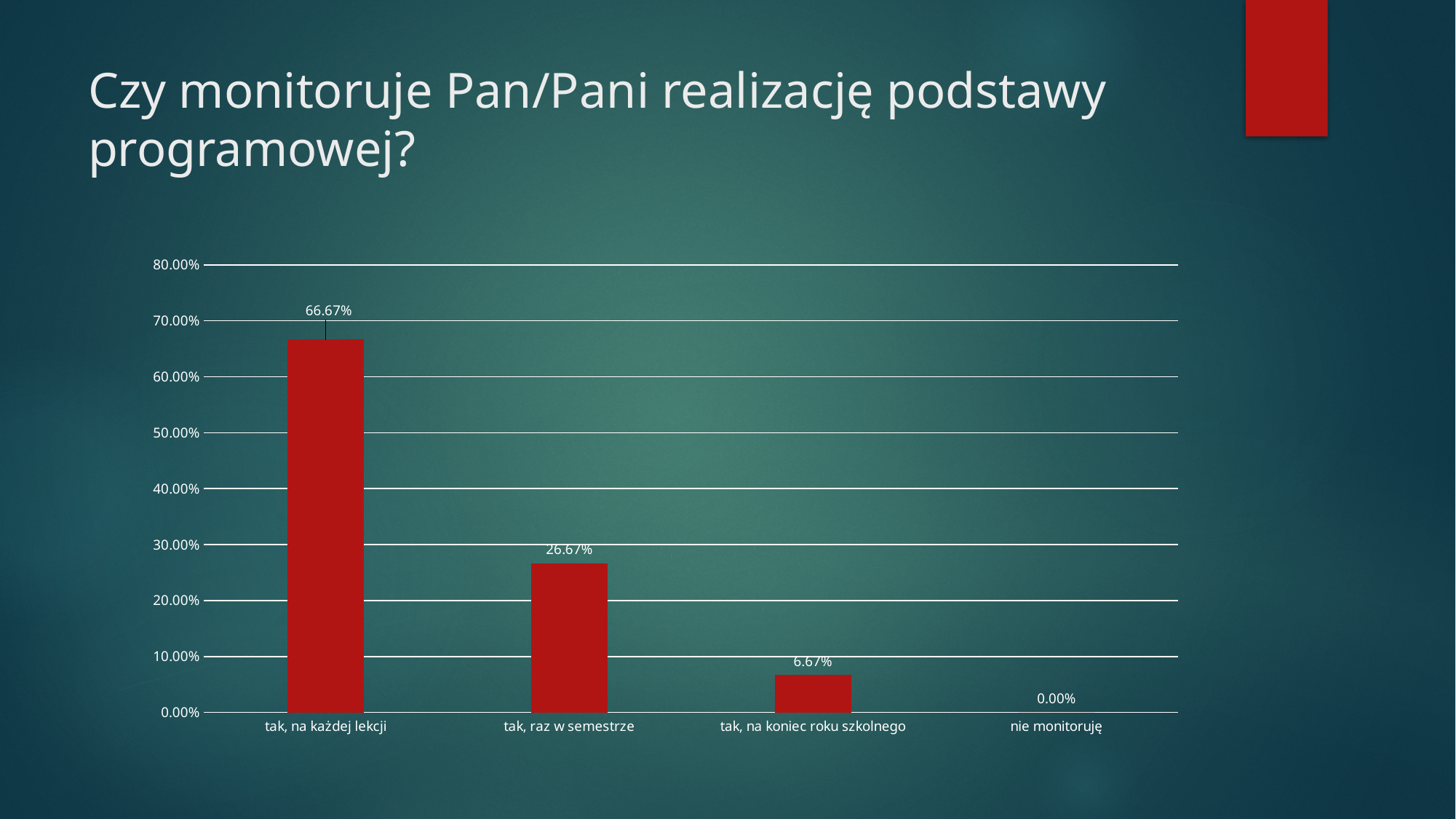
Which category has the highest value? tak, na każdej lekcji What is the value for "nie monitoruję"? 0.00% What is the value for "tak, raz w semestrze"? 26.67% Which is larger, the value for "tak, raz w semestrze" or the value for "tak, na koniec roku szkolnego"? tak, raz w semestrze What kind of chart is shown on the slide? bar chart What is the difference between the values for "tak, na każdej lekcji" and "tak, raz w semestrze"? 40.00% What is the value for "tak, na każdej lekcji"? 66.67% Do the values rise or fall from left to right along the x axis? fall How many categories are shown on the x axis? 4 Is the value for "tak, na każdej lekcji" greater or less than 60.00%? greater Which category has the lowest value? nie monitoruję What is the value for "tak, na koniec roku szkolnego"? 6.67%